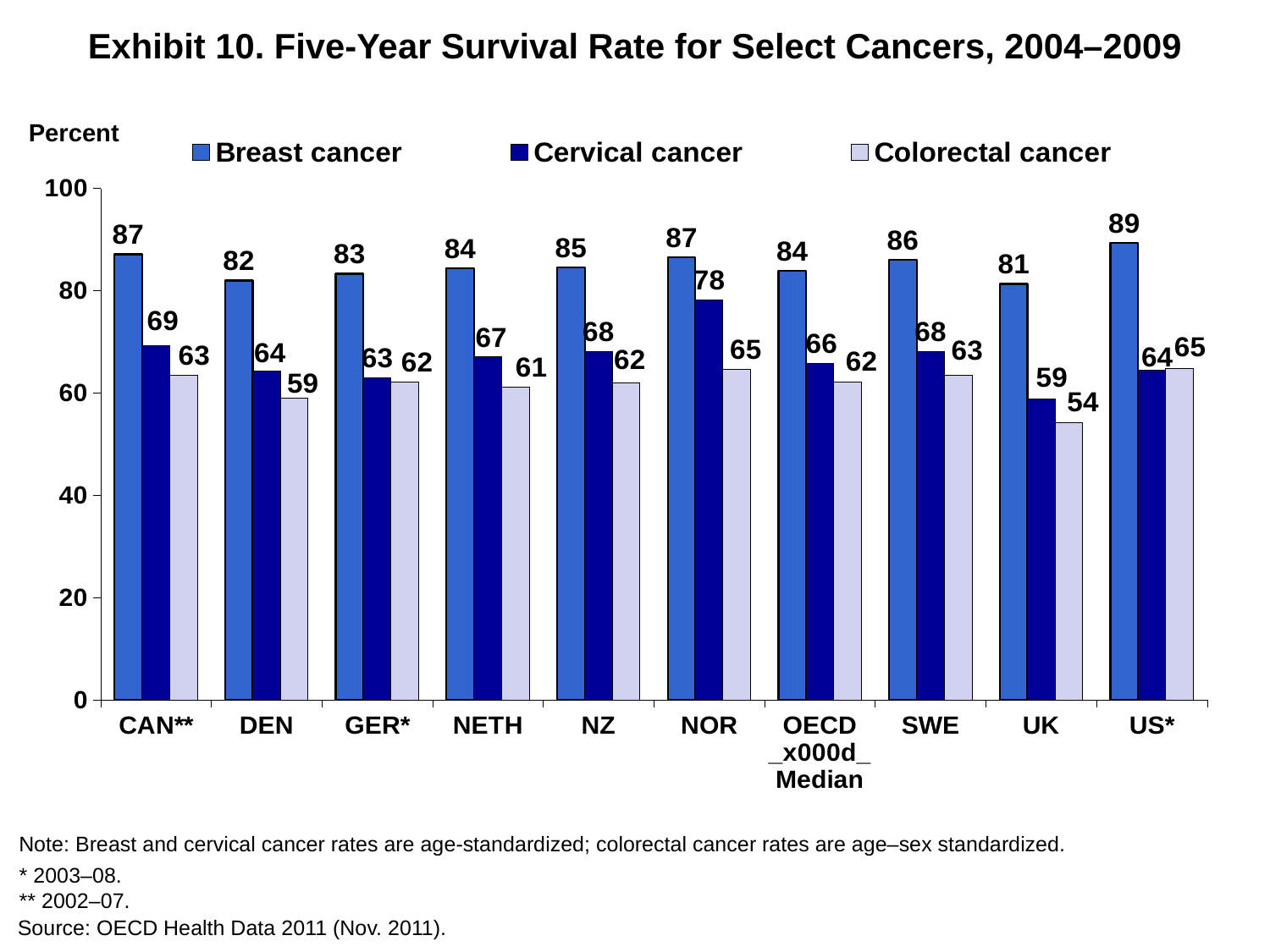
Which country has the highest breast cancer survival rate? US* What is the colorectal cancer five-year survival rate for the UK? 54 What is the source cited for the chart? OECD Health Data 2011 (Nov. 2011) What is the cervical cancer five-year survival rate for NOR? 78 What is the breast cancer five-year survival rate for the US*? 89 How many countries or groups are shown on the x axis? 10 Is the cervical cancer survival rate for the UK greater or less than 60? less What kind of chart is shown on the slide? Bar chart Which is larger, the cervical cancer survival rate for NOR or for SWE? NOR What is the difference between the breast cancer and cervical cancer survival rates for CAN**? 18 How many series does the legend list? 3 Which country has the lowest colorectal cancer survival rate? UK